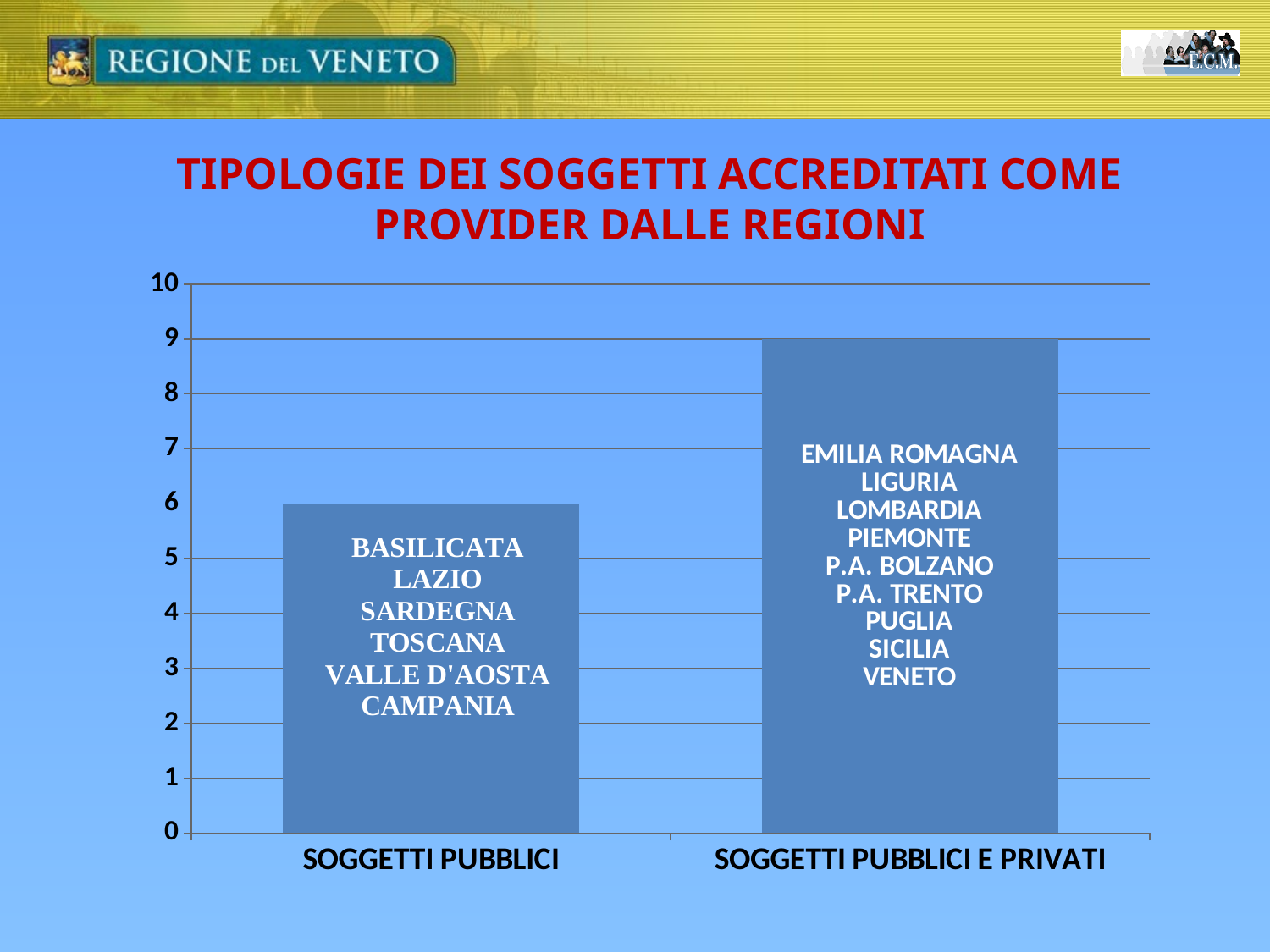
What is the difference between the values for SOGGETTI PUBBLICI E PRIVATI and SOGGETTI PUBBLICI? 3 Is the value for SOGGETTI PUBBLICI E PRIVATI greater or less than 5? greater What is the value for SOGGETTI PUBBLICI E PRIVATI? 9 Which is larger, the value for SOGGETTI PUBBLICI or the value for SOGGETTI PUBBLICI E PRIVATI? SOGGETTI PUBBLICI E PRIVATI Which category has the lowest value? SOGGETTI PUBBLICI How many categories are shown on the x axis of the chart? 2 What type of chart is shown on the slide? bar chart What is the value for SOGGETTI PUBBLICI? 6 What is the maximum value shown on the y axis of the chart? 10 Is the value for SOGGETTI PUBBLICI greater or less than 8? less Which category has the highest value? SOGGETTI PUBBLICI E PRIVATI What is the title of the chart on the slide? TIPOLOGIE DEI SOGGETTI ACCREDITATI COME PROVIDER DALLE REGIONI